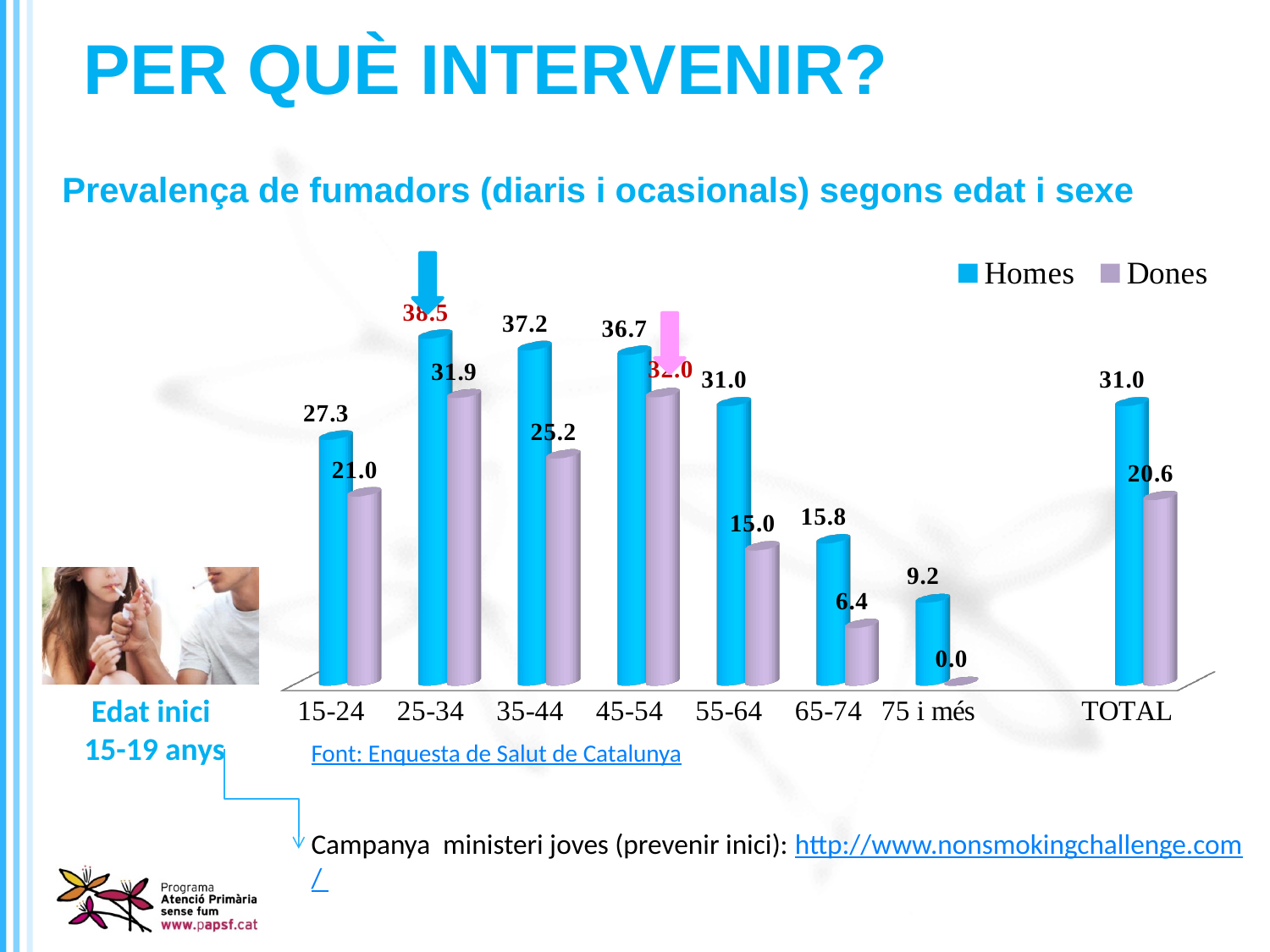
Which category has the lowest value for Dones? 75 i més What is the value for Dones in the 35-44 age group? 25.2 What is the value for Homes in the TOTAL category? 31.0 What is the value for Dones in the 75 i més age group? 0.0 What kind of chart is shown on the slide? Bar chart What is the difference between the Homes and Dones values in the 65-74 age group? 9.4 What is the value for Homes in the 15-24 age group? 27.3 In the 55-64 age group, which series has the larger value, Homes or Dones? Homes How many categories are shown on the x axis of the chart? 8 Which age group has the highest value for Homes? 25-34 How many series does the legend list? 2 What is the difference between the Homes and Dones values in the TOTAL category? 10.4